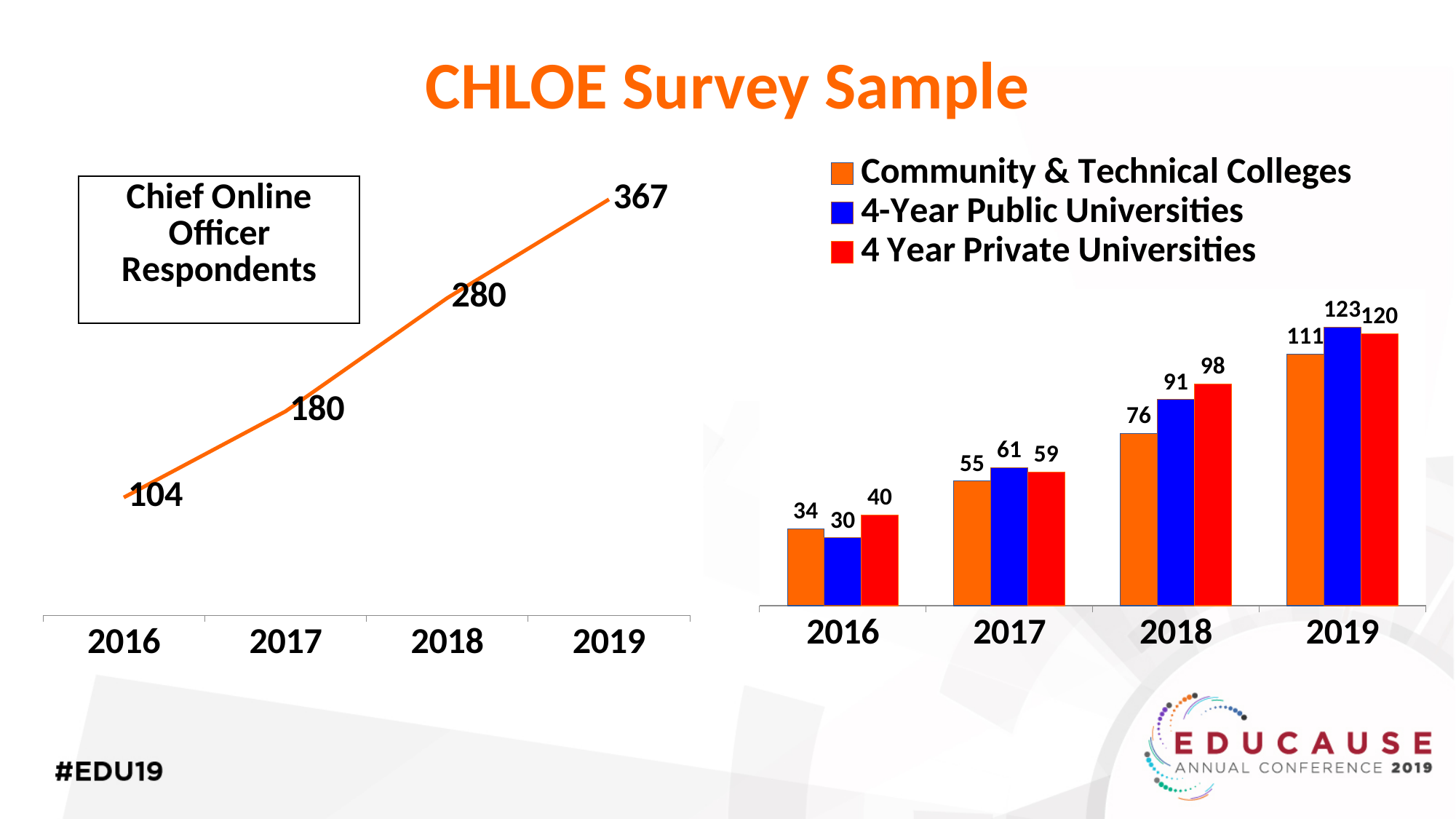
In the Chief Online Officer Respondents line chart on the left, which year has the lowest value? 2016 In the Chief Online Officer Respondents line chart on the left, do the values rise or fall from 2016 to 2019? rise In the Chief Online Officer Respondents line chart on the left, how many years are plotted? 4 How many series does the legend of the bar chart on the right list? 3 In the bar chart on the right, what is the difference between 4 Year Private Universities in 2019 and in 2018? 22 In the Chief Online Officer Respondents line chart on the left, what is the difference between the 2019 and 2016 values? 263 In the bar chart on the right, what is the value for 4-Year Public Universities in 2018? 91 In the Chief Online Officer Respondents line chart on the left, what is the value for 2018? 280 In the bar chart on the right, which series has the highest value in 2019? 4-Year Public Universities In the bar chart on the right, which is larger in 2017: 4-Year Public Universities or 4 Year Private Universities? 4-Year Public Universities What type of chart is the chart on the left of the slide? line chart In the bar chart on the right, what is the value for Community & Technical Colleges in 2016? 34